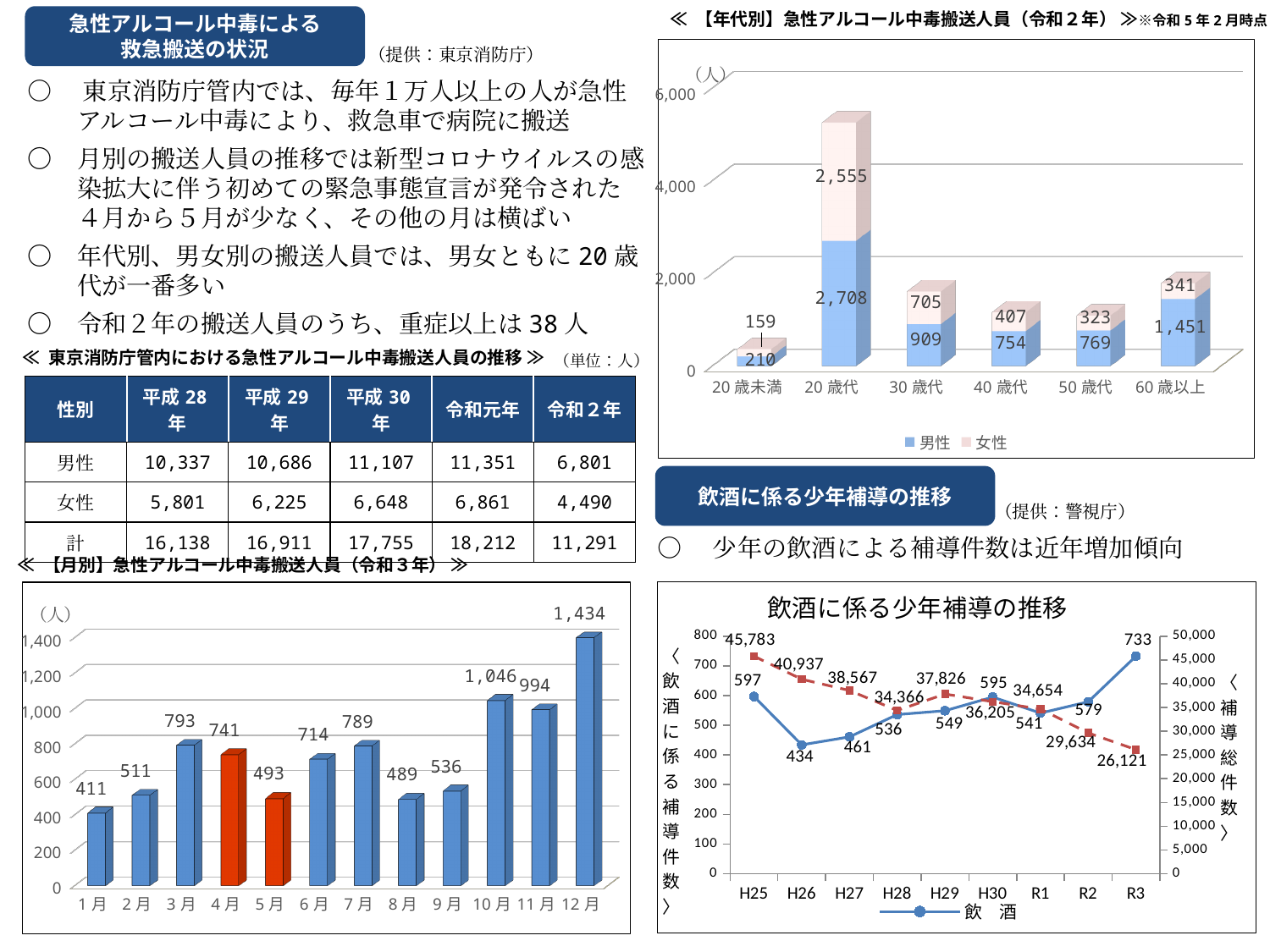
In the chart titled 飲酒に係る少年補導の推移, what is the value of the 補導総件数 series for R3? 26,121 In the chart titled 【年代別】急性アルコール中毒搬送人員（令和２年）, which age category has the highest total? 20歳代 In the chart titled 【年代別】急性アルコール中毒搬送人員（令和２年）, what is the value for 女性 in the 40歳代 category? 407 In the chart titled 【年代別】急性アルコール中毒搬送人員（令和２年）, what is the total of the stacked bar for 30歳代? 1,614 In the chart titled 飲酒に係る少年補導の推移, does the 補導総件数 series generally rise or fall from H25 to R3? fall In the chart titled 【月別】急性アルコール中毒搬送人員（令和３年）, what is the difference between the values for 12月 and 11月? 440 In the chart titled 【年代別】急性アルコール中毒搬送人員（令和２年）, what is the value for 男性 in the 20歳代 category? 2,708 In the chart titled 【月別】急性アルコール中毒搬送人員（令和３年）, which month has the lowest value? 1月 In the chart titled 飲酒に係る少年補導の推移, what is the value of the 飲酒 series for H26? 434 In the chart titled 【月別】急性アルコール中毒搬送人員（令和３年）, how many months are plotted? 12 In the chart titled 【月別】急性アルコール中毒搬送人員（令和３年）, what is the value for 10月? 1,046 In the chart titled 【年代別】急性アルコール中毒搬送人員（令和２年）, how many series does the legend list? 2